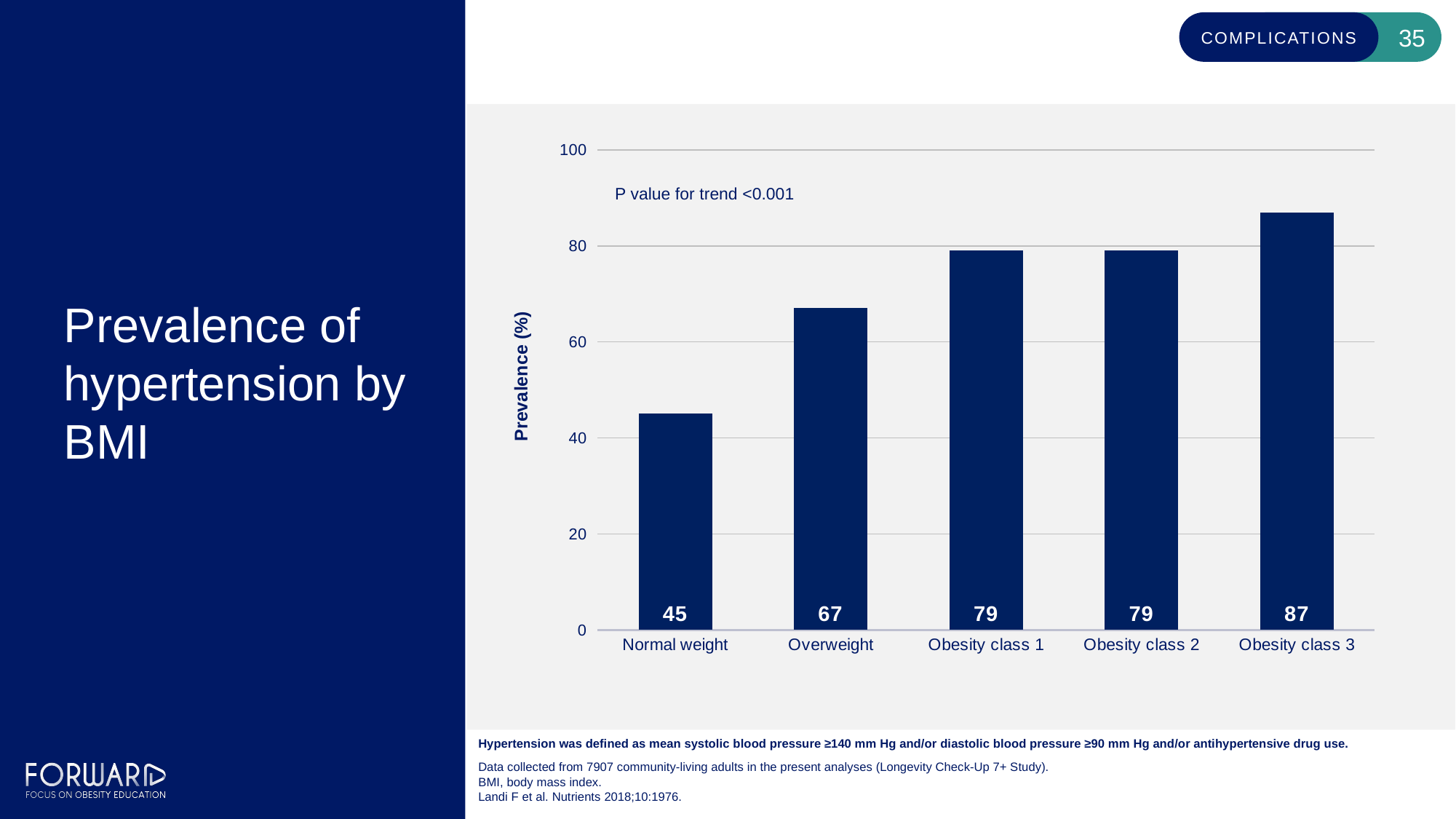
Which BMI category has the lowest prevalence of hypertension? Normal weight What is the difference in prevalence between Overweight and Normal weight? 22 What kind of chart is shown on the slide? Bar chart What is the label of the y axis of the chart? Prevalence (%) How many BMI categories are shown on the chart? 5 What is the prevalence of hypertension for the Normal weight category? 45 Which BMI category has the highest prevalence of hypertension? Obesity class 3 What is the prevalence of hypertension for the Overweight category? 67 What is the difference in prevalence between Obesity class 3 and Normal weight? 42 Which has a higher prevalence of hypertension, Overweight or Obesity class 1? Obesity class 1 What is the prevalence of hypertension for Obesity class 3? 87 Do the prevalence values generally rise or fall from Normal weight to Obesity class 3? Rise